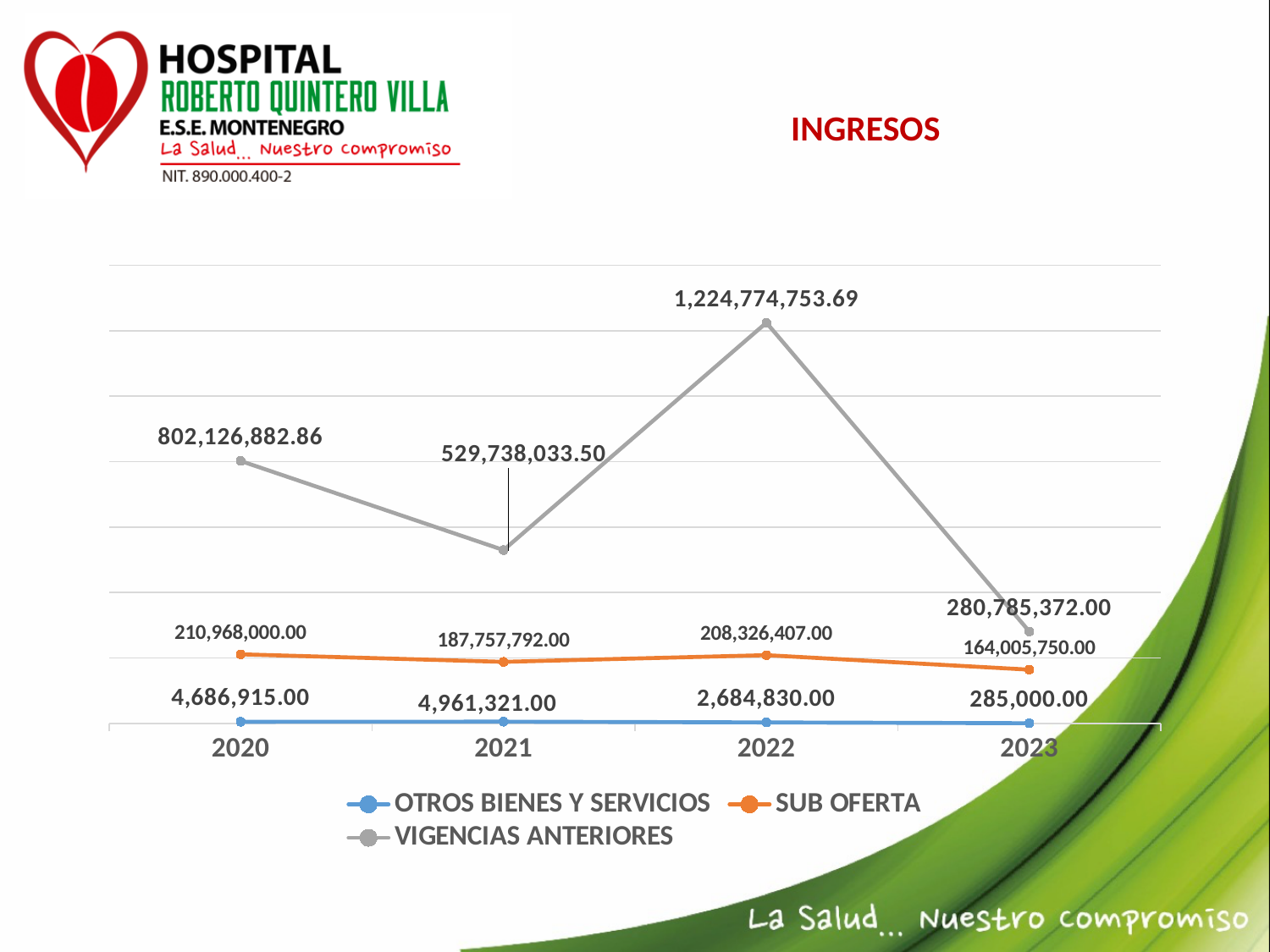
What is the difference between the SUB OFERTA values for 2020 and 2023? 46,962,250.00 What is the value for OTROS BIENES Y SERVICIOS in 2023? 285,000.00 What is the title of the chart? INGRESOS How many series does the legend list? 3 What is the value for SUB OFERTA in 2021? 187,757,792.00 In which year is SUB OFERTA lowest? 2023 What type of chart is shown on the slide? line chart What is the value for VIGENCIAS ANTERIORES in 2022? 1,224,774,753.69 How many years are shown on the x axis? 4 In which year is VIGENCIAS ANTERIORES highest? 2022 Which is larger, OTROS BIENES Y SERVICIOS in 2021 or in 2022? 2021 What is the difference between the VIGENCIAS ANTERIORES values for 2022 and 2020? 422,647,870.83